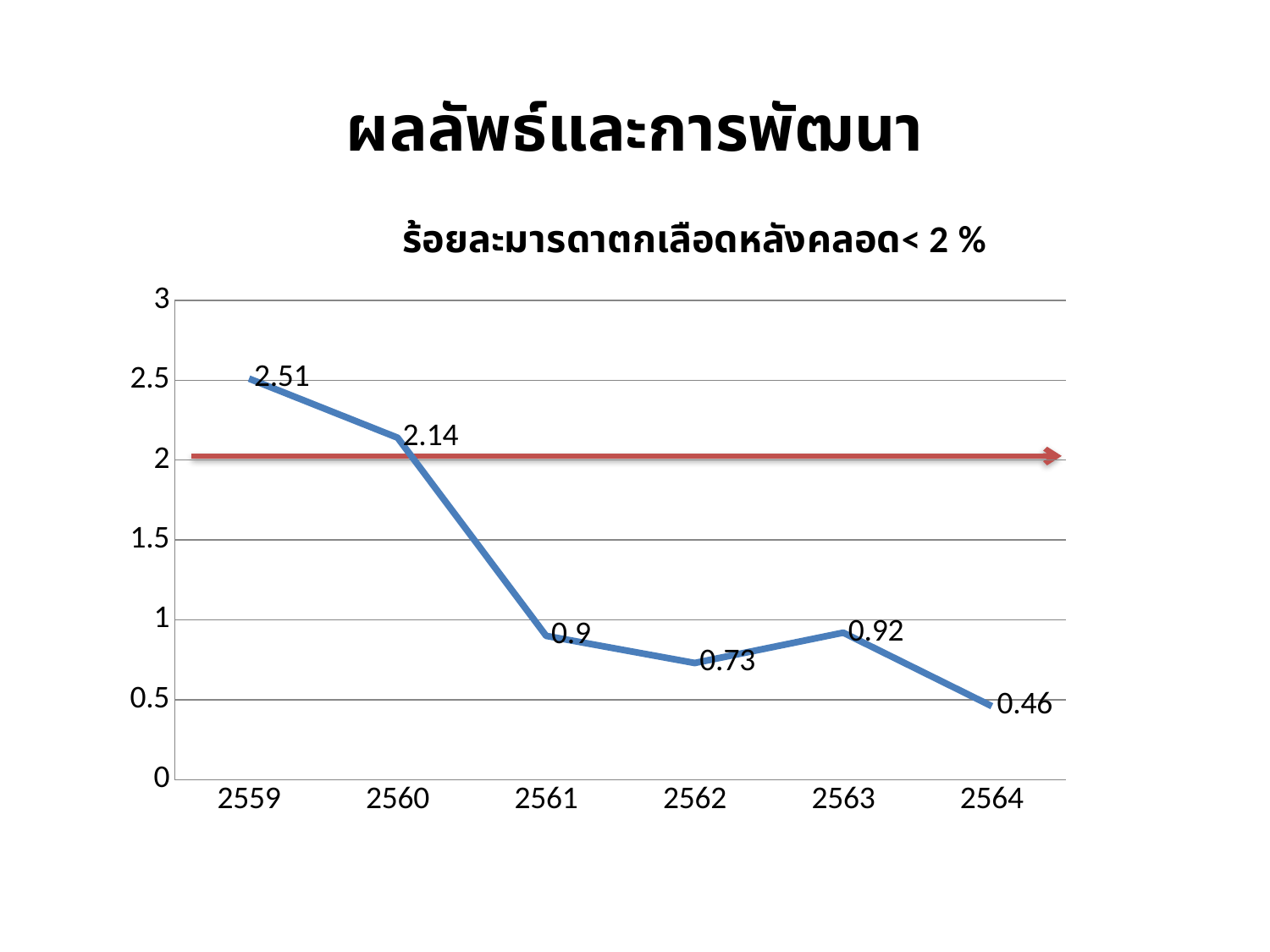
What is the value for 2559? 2.51 Which year has the highest value? 2559 Is the value for 2561 greater or less than 1? less Which is larger, the value for 2561 or the value for 2563? 2563 What is the difference between the values for 2559 and 2560? 0.37 What kind of chart is shown? line chart What is the value for 2564? 0.46 Which year has the lowest value? 2564 Do the values generally rise or fall from 2559 to 2564? fall What is the difference between the values for 2563 and 2564? 0.46 How many years are plotted on the x axis? 6 What is the value for 2562? 0.73